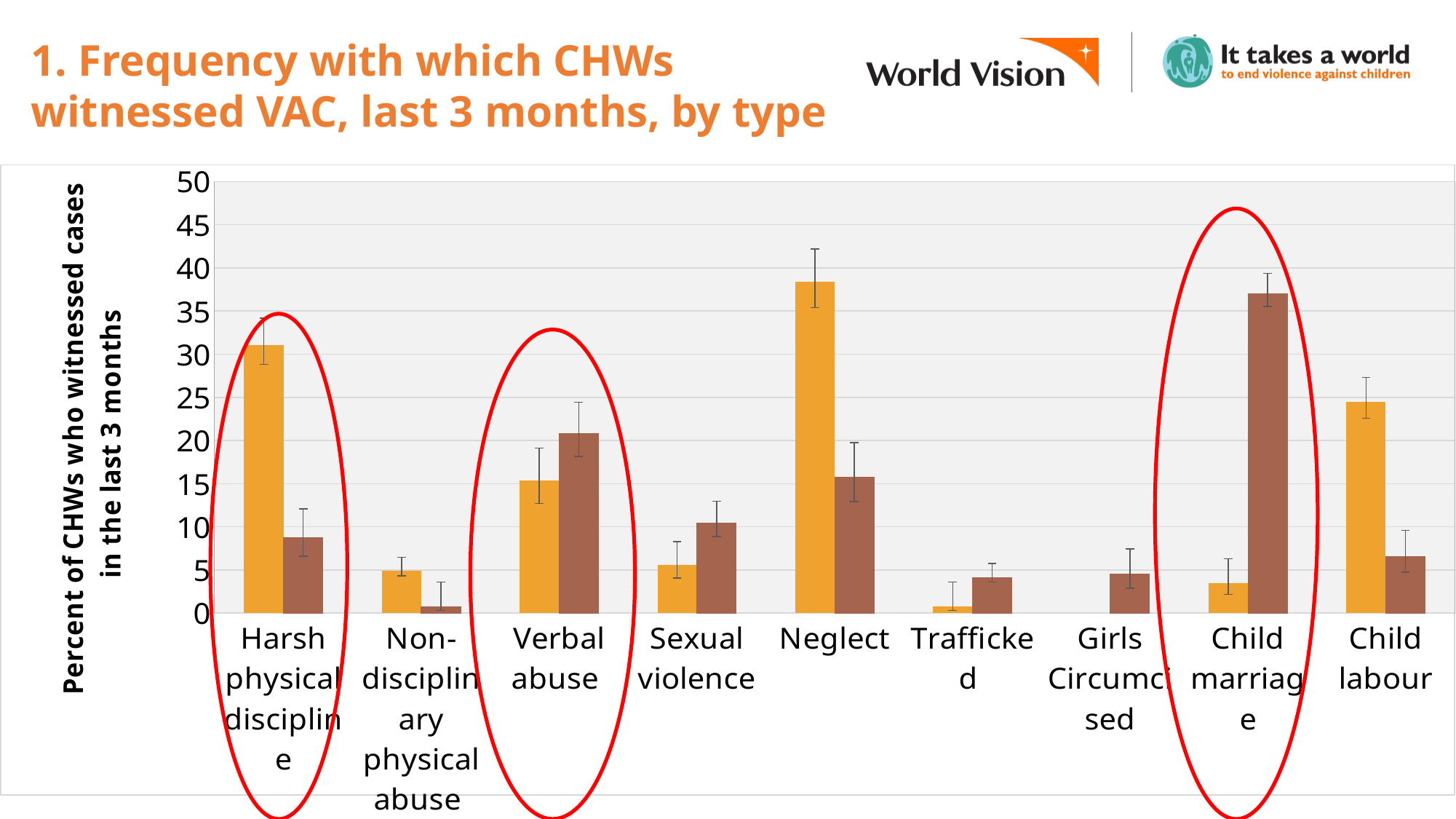
What is the label on the y axis? Percent of CHWs who witnessed cases in the last 3 months For Harsh physical discipline, which bar is taller, the orange or the brown one? orange How many categories of violence are shown on the x axis? 9 Which category has the tallest brown bar? Child marriage For Verbal abuse, which bar is taller, the orange or the brown one? brown Which category has the tallest orange bar? Neglect Is the brown bar for Child marriage greater or less than 30? greater Which category has the shortest brown bar? Non-disciplinary physical abuse Is the orange bar for Child labour greater or less than 20? greater What kind of chart is shown on the slide? bar chart Is the brown bar for Harsh physical discipline greater or less than 15? less